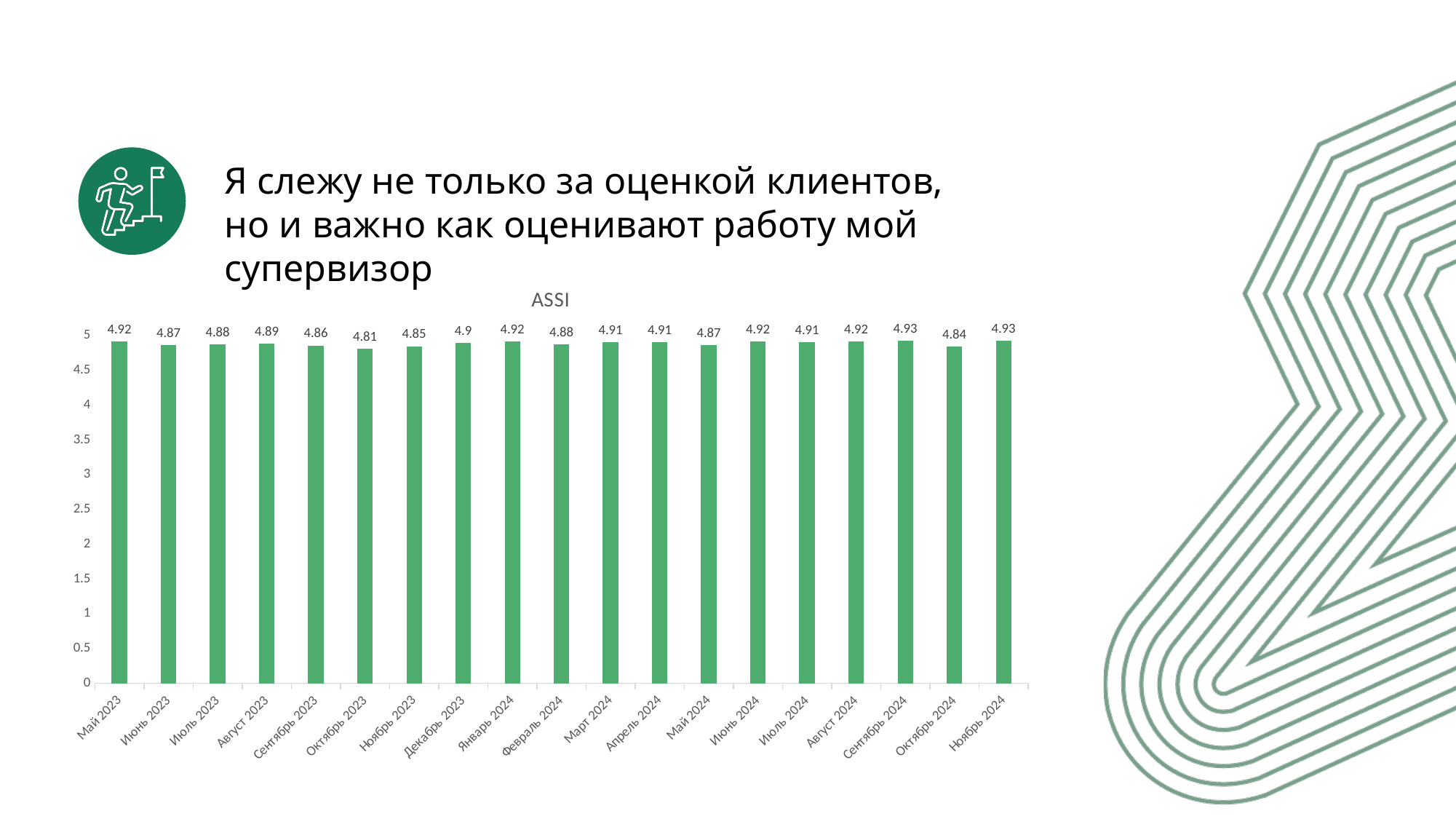
What is the value for Октябрь 2024 in the ASSI chart? 4.84 What is the value for Май 2023 in the ASSI chart? 4.92 What is the value for Декабрь 2023 in the ASSI chart? 4.9 Is the value for Июнь 2023 in the ASSI chart greater or less than 4.5? greater What is the title of the chart on the slide? ASSI What is the value for Ноябрь 2024 in the ASSI chart? 4.93 What is the difference between the values for Май 2023 and Октябрь 2023 in the ASSI chart? 0.11 Which month has the lowest value in the ASSI chart? Октябрь 2023 What kind of chart is shown on the slide? bar chart How many months are shown on the x axis of the ASSI chart? 19 What is the value for Октябрь 2023 in the ASSI chart? 4.81 Which is larger in the ASSI chart: the value for Сентябрь 2024 or Октябрь 2024? Сентябрь 2024